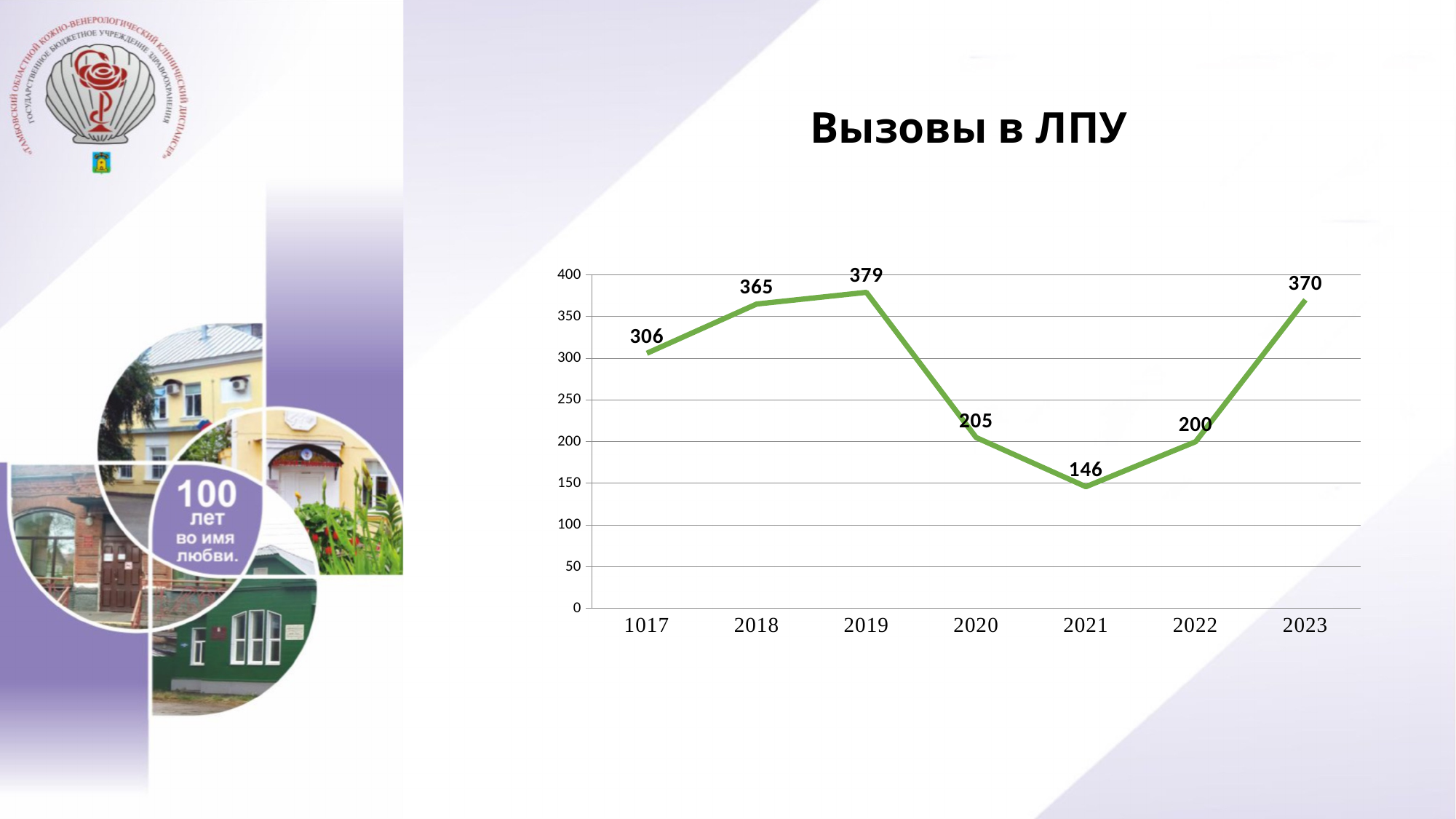
Which year has the lowest value? 2021 What is the value for 2023? 370 What is the value for the first point, labelled 1017? 306 What is the value for 2019? 379 What is the value for 2021? 146 Which year has the highest value? 2019 Which is larger, the value for 2020 or the value for 2022? 2020 What is the title of the chart? Вызовы в ЛПУ What kind of chart is shown on the slide? Line chart How many data points are plotted on the chart? 7 What is the difference between the values for 2019 and 2021? 233 What is the difference between the values for 2023 and 2022? 170